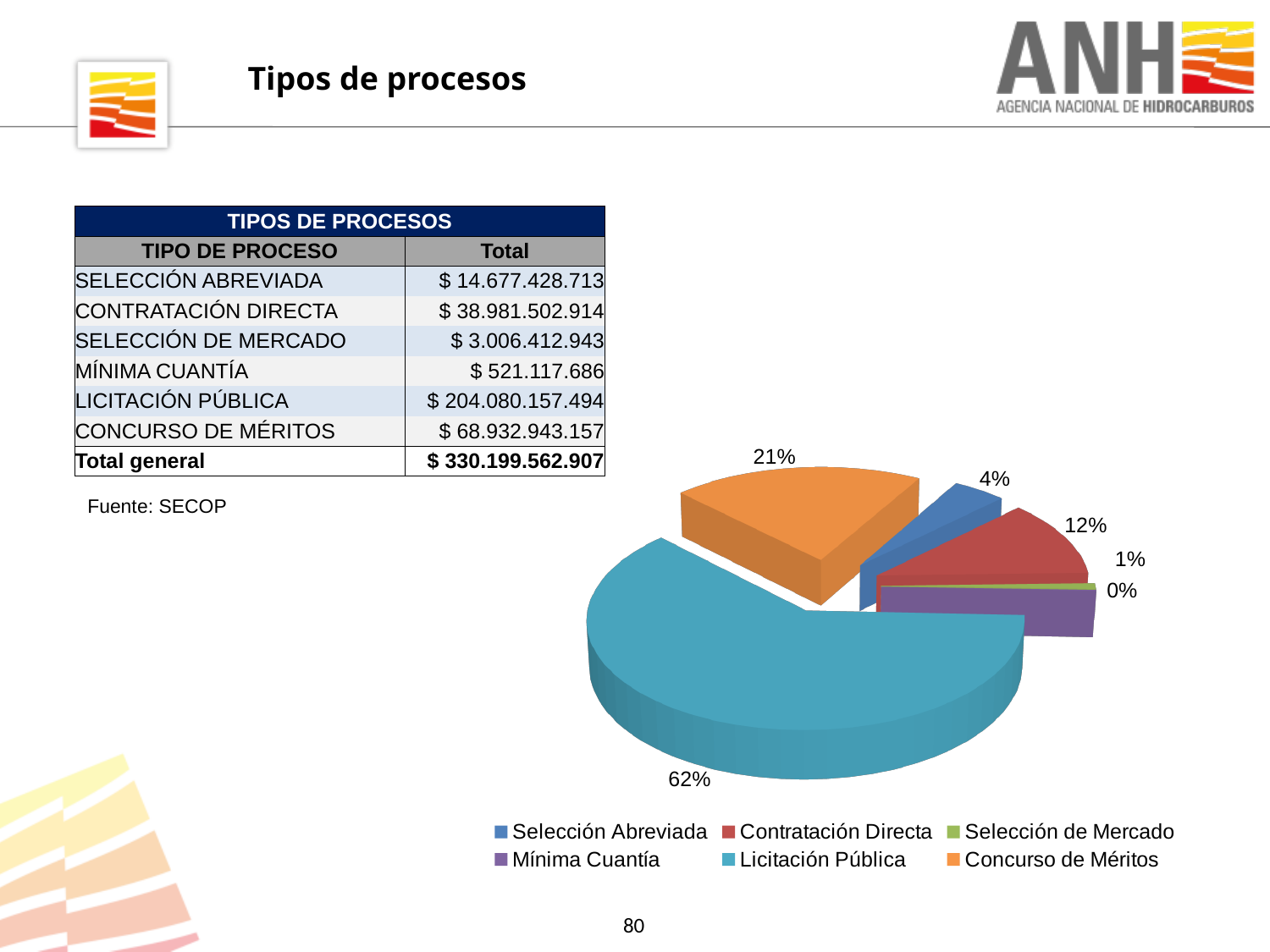
What share of the pie does Concurso de Méritos represent? 21% What share of the pie does Selección Abreviada represent? 4% What share of the pie does Contratación Directa represent? 12% Which slice is larger, Concurso de Méritos or Contratación Directa? Concurso de Méritos What kind of chart is shown on the slide? Pie chart How many categories does the pie chart legend list? 6 Which category has the smallest slice of the pie? Mínima Cuantía Which category has the largest slice of the pie? Licitación Pública What is the difference in percentage points between the Licitación Pública slice and the Concurso de Méritos slice? 41%